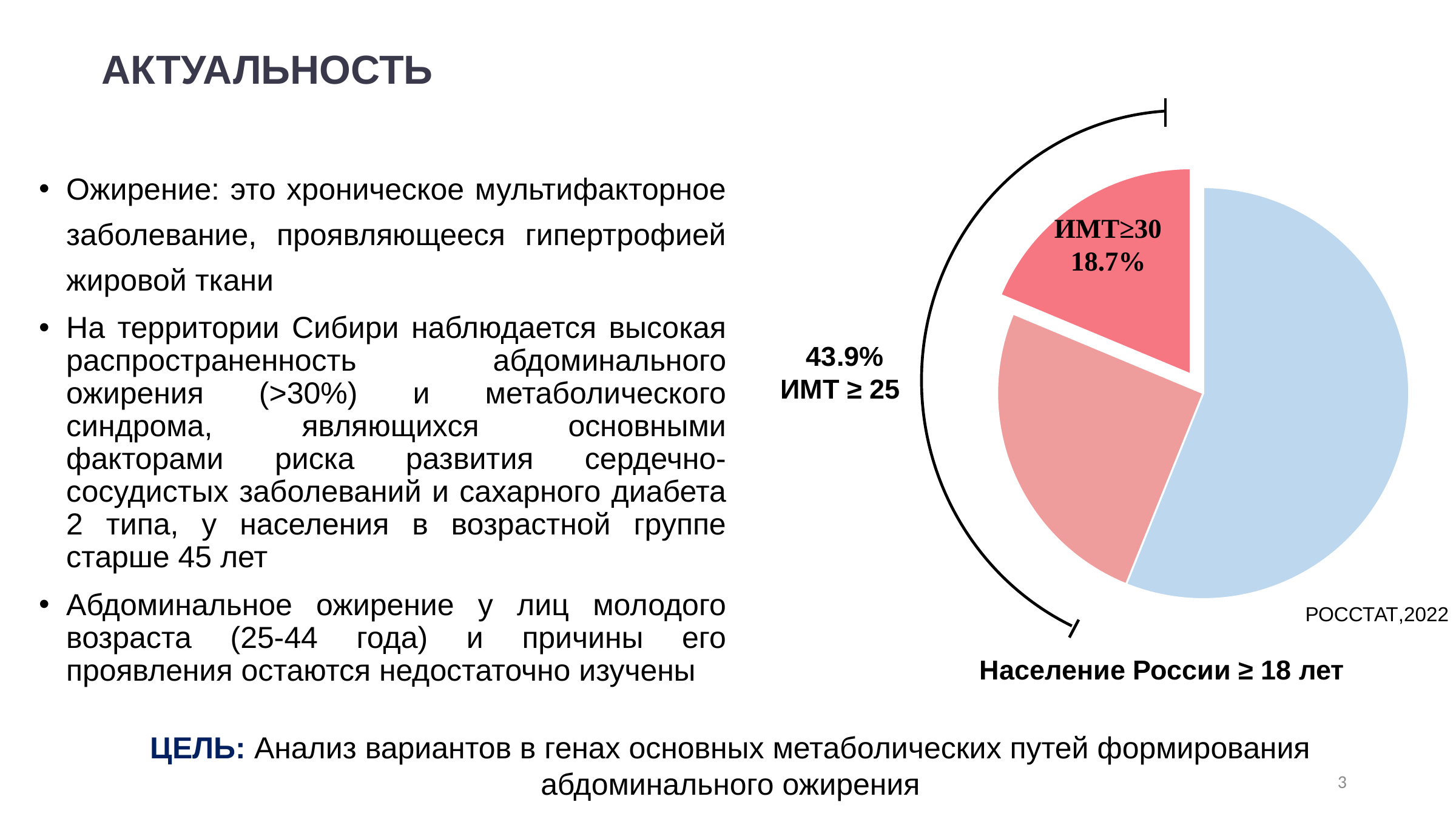
How many slices does the pie chart have? 3 What is the difference between the ИМТ ≥ 25 share (43.9%) and the ИМТ≥30 share (18.7%)? 25.2% Is the share for ИМТ≥30 greater or less than 20%? less Is the share for ИМТ ≥ 25 greater or less than 50%? less What population does the caption under the pie chart say it describes? Население России ≥ 18 лет What percentage is given for ИМТ ≥ 25 on the pie chart? 43.9% Which is larger: the slice labelled ИМТ≥30 or the large unlabelled blue slice? the blue slice Which slice of the pie chart is pulled out (exploded) from the rest? ИМТ≥30 What share of the pie does the slice labelled ИМТ≥30 represent? 18.7% What kind of chart is shown on the slide? pie chart